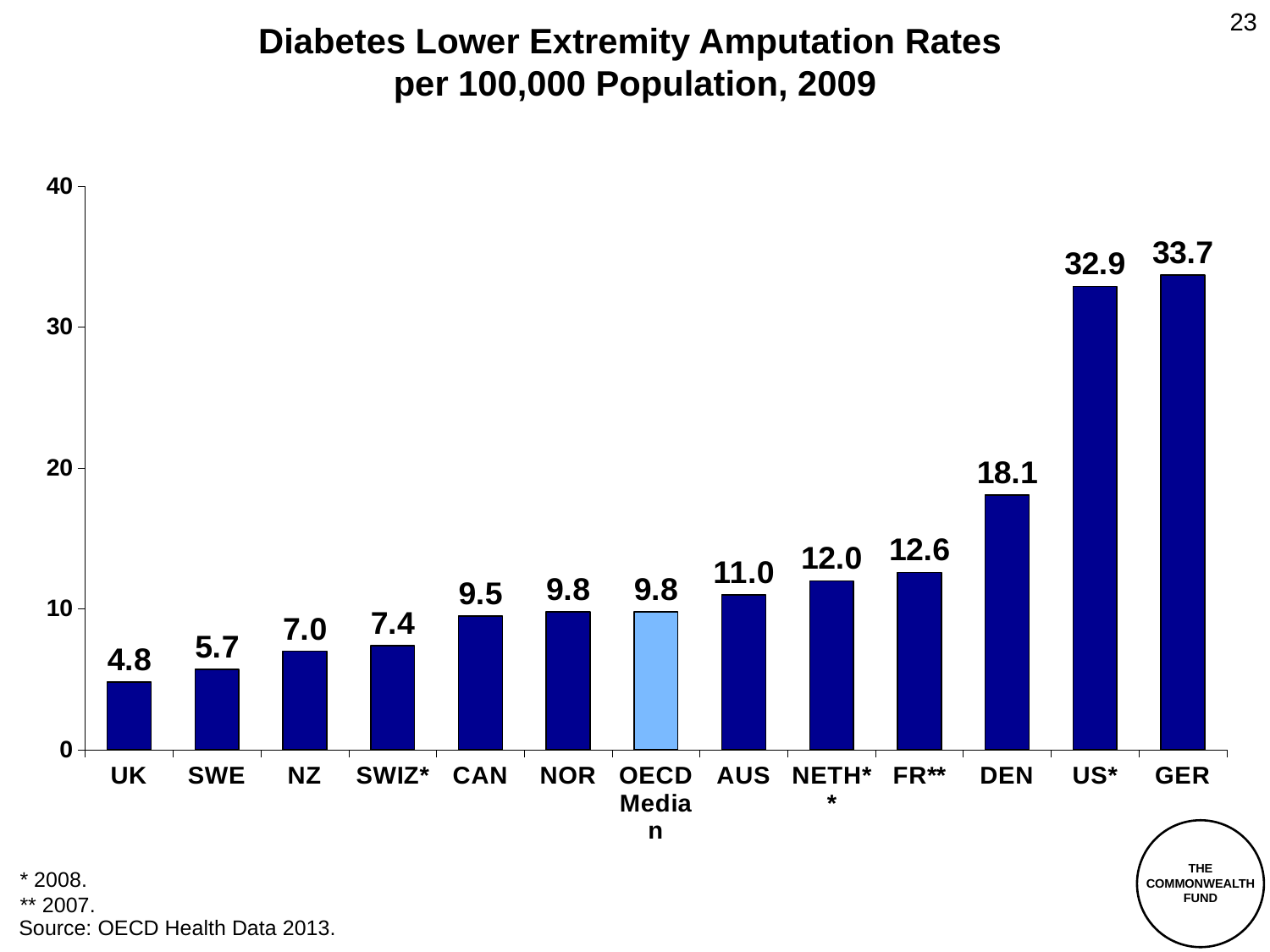
What is the difference between the rates for DEN and FR? 5.5 Is the value for DEN greater or less than 20? less Which country has the highest amputation rate on the chart? GER What is the diabetes lower extremity amputation rate for the US? 32.9 Which bar is shown in a lighter blue colour than the others? OECD Median Which country has the lowest amputation rate on the chart? UK What is the amputation rate for Denmark (DEN)? 18.1 Which has a higher amputation rate, NETH or AUS? NETH What is the value shown for the OECD Median? 9.8 What kind of chart is shown on the slide? bar chart How many bars are shown on the chart? 13 What is the difference between the rates for GER and US? 0.8